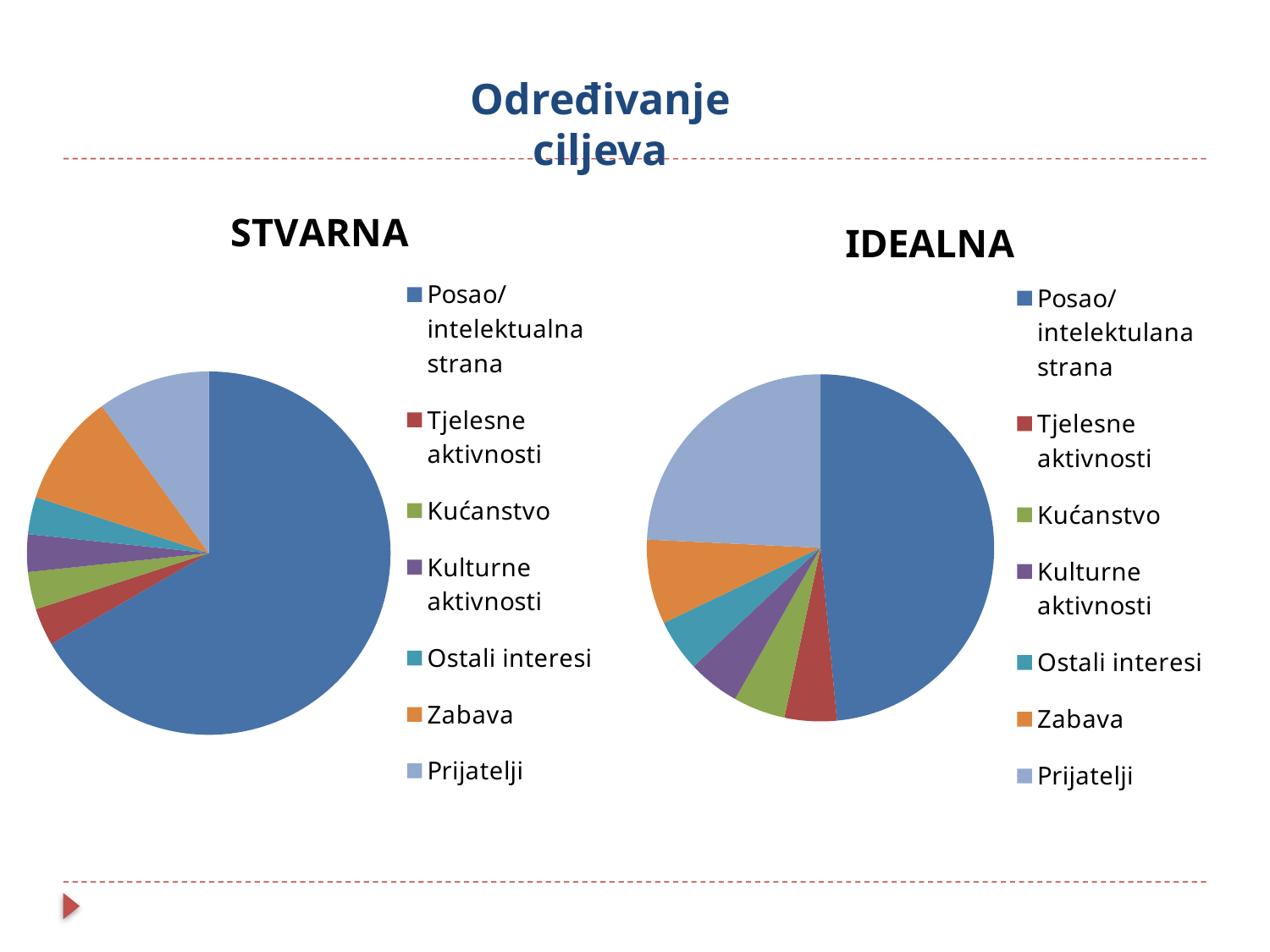
What kind of chart is the IDEALNA chart? pie chart In the IDEALNA chart, which category has the largest slice? Posao/intelektulana strana What kind of chart is the STVARNA chart? pie chart How many categories does the STVARNA pie chart have? 7 In the STVARNA chart, which category has the largest slice? Posao/intelektualna strana In the IDEALNA chart, which slice is larger: Prijatelji or Zabava? Prijatelji In the IDEALNA chart, which slice is larger: Zabava or Tjelesne aktivnosti? Zabava In the STVARNA chart, which slice is larger: Posao/intelektualna strana or Zabava? Posao/intelektualna strana How many entries does the legend of the IDEALNA chart list? 7 How many categories does the IDEALNA pie chart have? 7 What colour is the Zabava slice in the STVARNA chart? orange